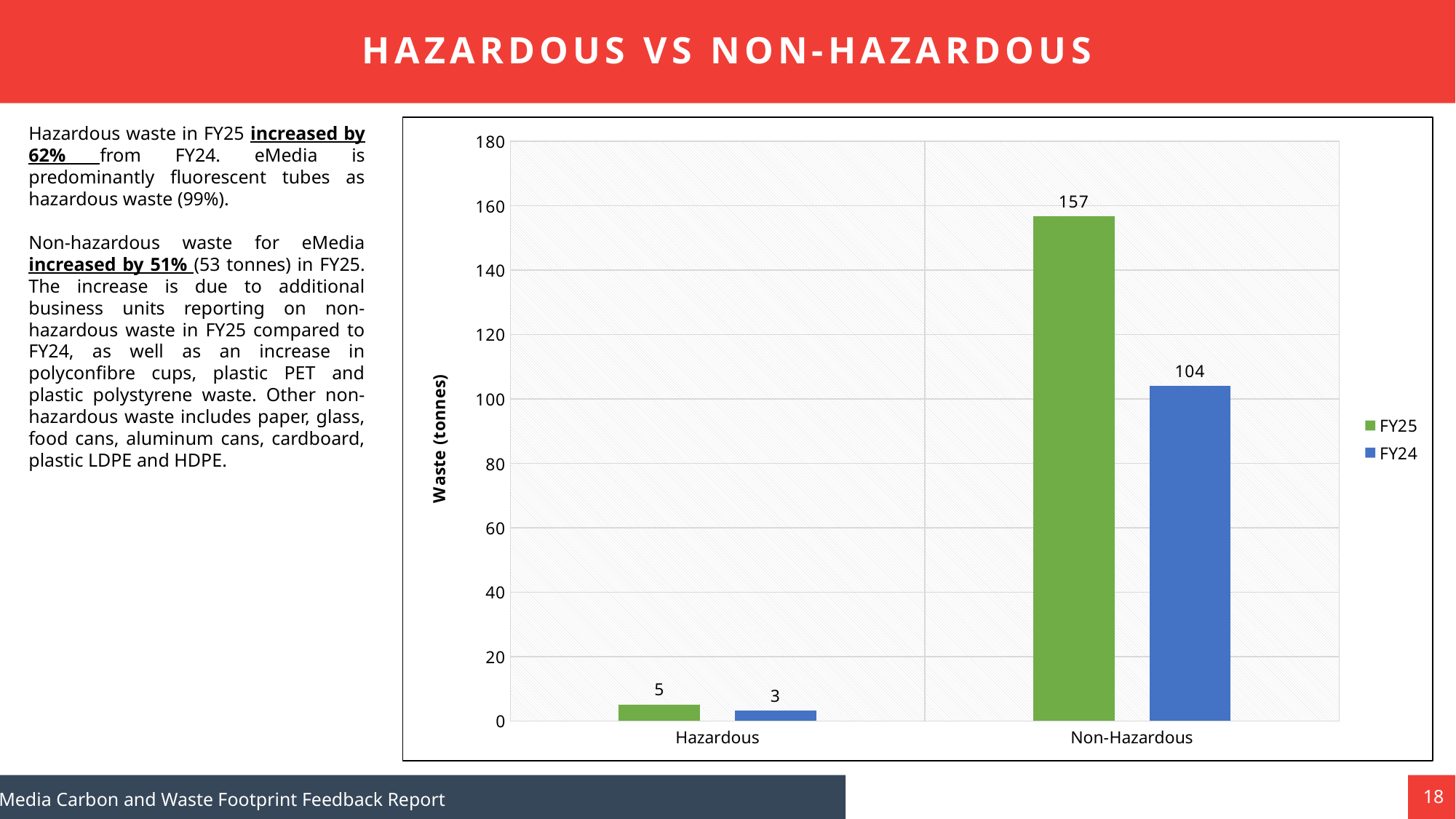
What is the FY24 value for Hazardous waste? 3 How many series does the legend list? 2 What is the FY25 value for Non-Hazardous waste? 157 What is the FY25 value for Hazardous waste? 5 Which category has the lowest FY24 value? Hazardous What is the difference between the FY25 and FY24 values for Non-Hazardous waste? 53 Which category has the highest FY25 value? Non-Hazardous How many categories are shown on the x axis? 2 What is the FY24 value for Non-Hazardous waste? 104 Which is larger for Hazardous waste, the FY25 value or the FY24 value? FY25 What kind of chart is shown on the slide? Bar chart What is the label of the y axis? Waste (tonnes)